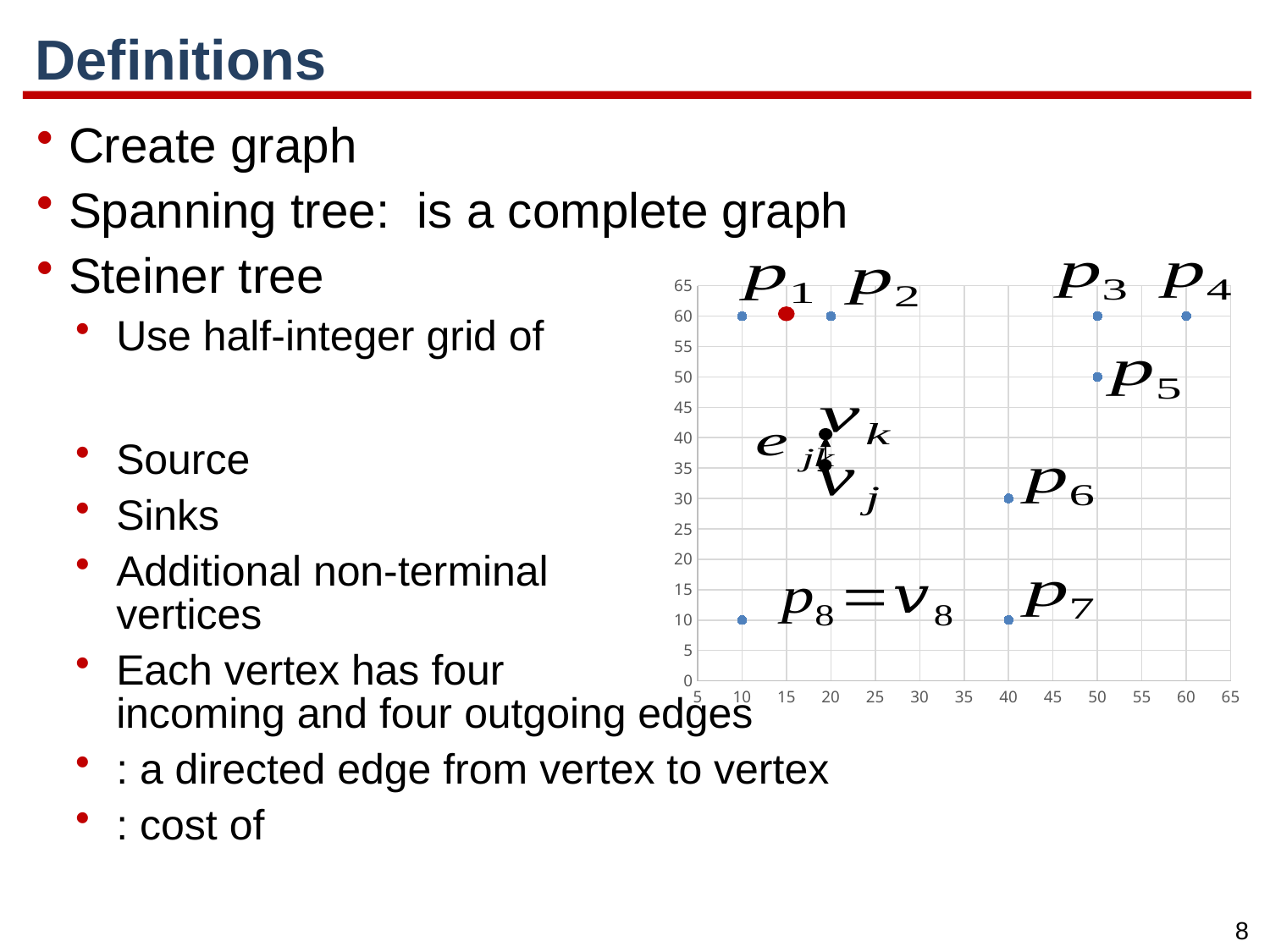
What is the difference in y coordinate between the point labelled p6 and the point labelled p7? 20 What is the x coordinate of the point labelled p6? 40 What is the y coordinate of the point labelled p6? 30 What is the x coordinate of the point labelled p7? 40 What is the y coordinate of the point labelled p5? 50 Which has the larger y coordinate, the point labelled p5 or the point labelled p6? p5 What is the lowest value shown on the y axis of the chart? 0 What is the highest value shown on the x axis of the chart? 65 What is the y coordinate of the point labelled p8 = v8? 10 How many blue data points are plotted on the chart? 8 Is the y coordinate of the point labelled p4 greater or less than 50? greater What kind of chart is shown on the slide? scatter chart